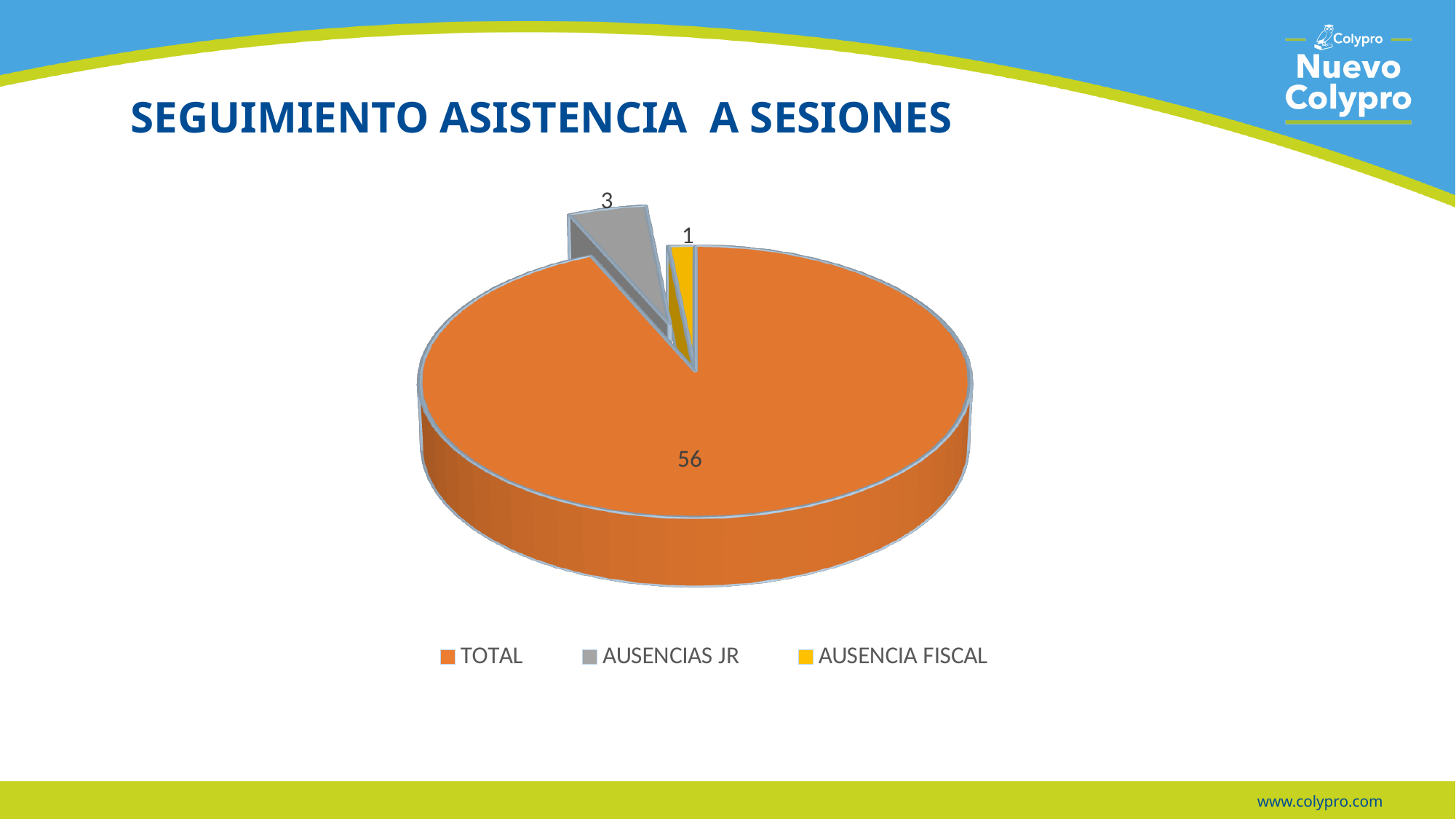
Which category has the largest slice? TOTAL Which is larger, AUSENCIAS JR or AUSENCIA FISCAL? AUSENCIAS JR What kind of chart is shown on the slide? Pie chart What is the title of the slide? SEGUIMIENTO ASISTENCIA A SESIONES What is the value for AUSENCIA FISCAL? 1 What is the difference between the values for AUSENCIAS JR and AUSENCIA FISCAL? 2 What colour is the TOTAL slice? Orange Which category has the smallest slice? AUSENCIA FISCAL How many slices does the pie chart have? 3 What is the value for AUSENCIAS JR? 3 What is the value for TOTAL? 56 What is the difference between the values for TOTAL and AUSENCIAS JR? 53